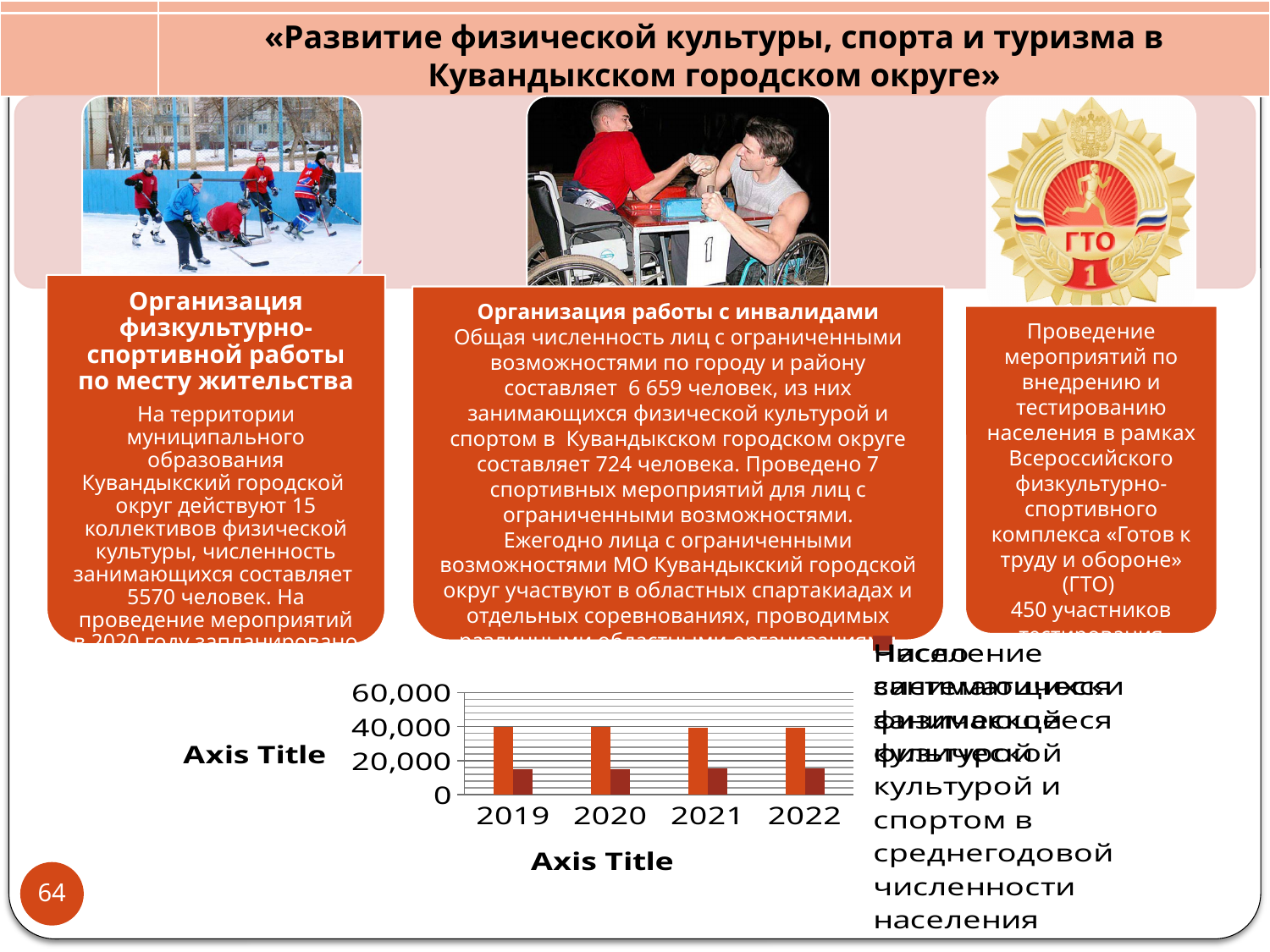
What is the highest tick value shown on the chart's vertical axis? 60,000 Is the value of the orange bar for 2019 greater or less than 20,000? greater In 2020, which bar is taller, the orange one or the dark red one? the orange one How many series does the chart's legend list? 2 Is the value of the dark red bar for 2019 greater or less than 20,000? less Is the value of the dark red bar for 2021 greater or less than 40,000? less In 2022, which bar is shorter, the orange one or the dark red one? the dark red one How many years are shown on the x axis of the chart? 4 What is the first year shown on the x axis of the chart? 2019 What kind of chart is shown at the bottom of the slide? bar chart